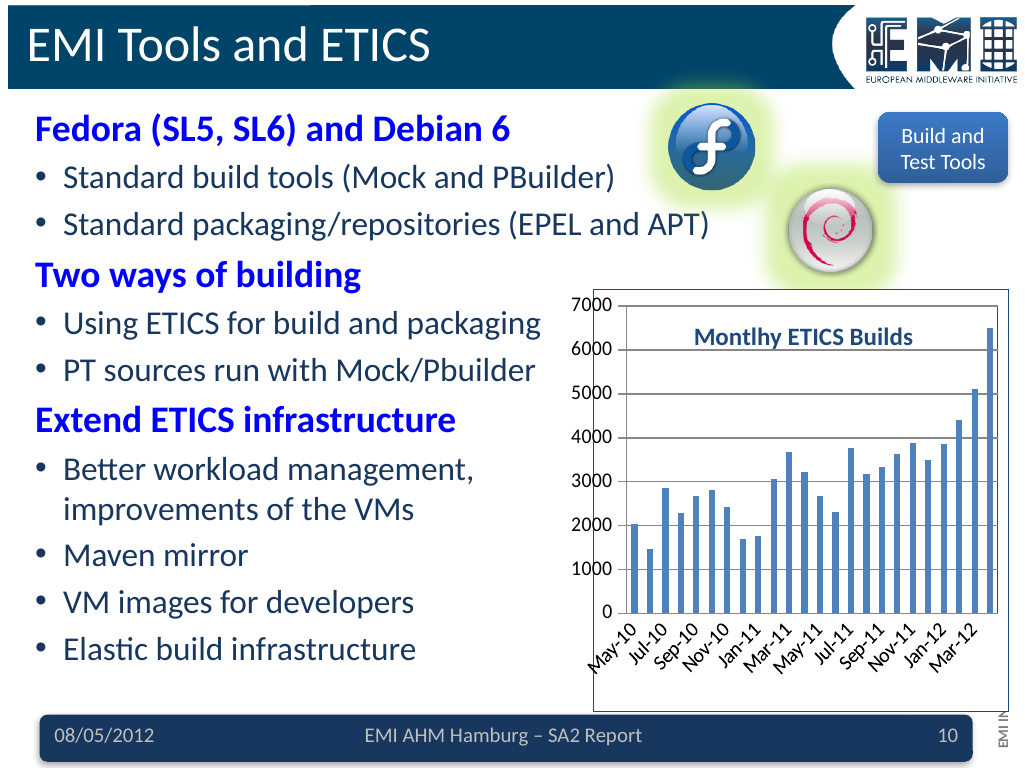
Is the value for Jul-10 greater or less than 2000? greater Is the value for Mar-12 greater or less than 4000? greater Is the value for Jul-11 greater or less than 3000? greater Which has the larger value, May-10 or Mar-12? Mar-12 What is the title of the chart? Montlhy ETICS Builds Which has the larger value, Jan-11 or Mar-11? Mar-11 What kind of chart is shown on the slide? bar chart Do the monthly ETICS builds generally rise or fall from May-10 to Mar-12? rise